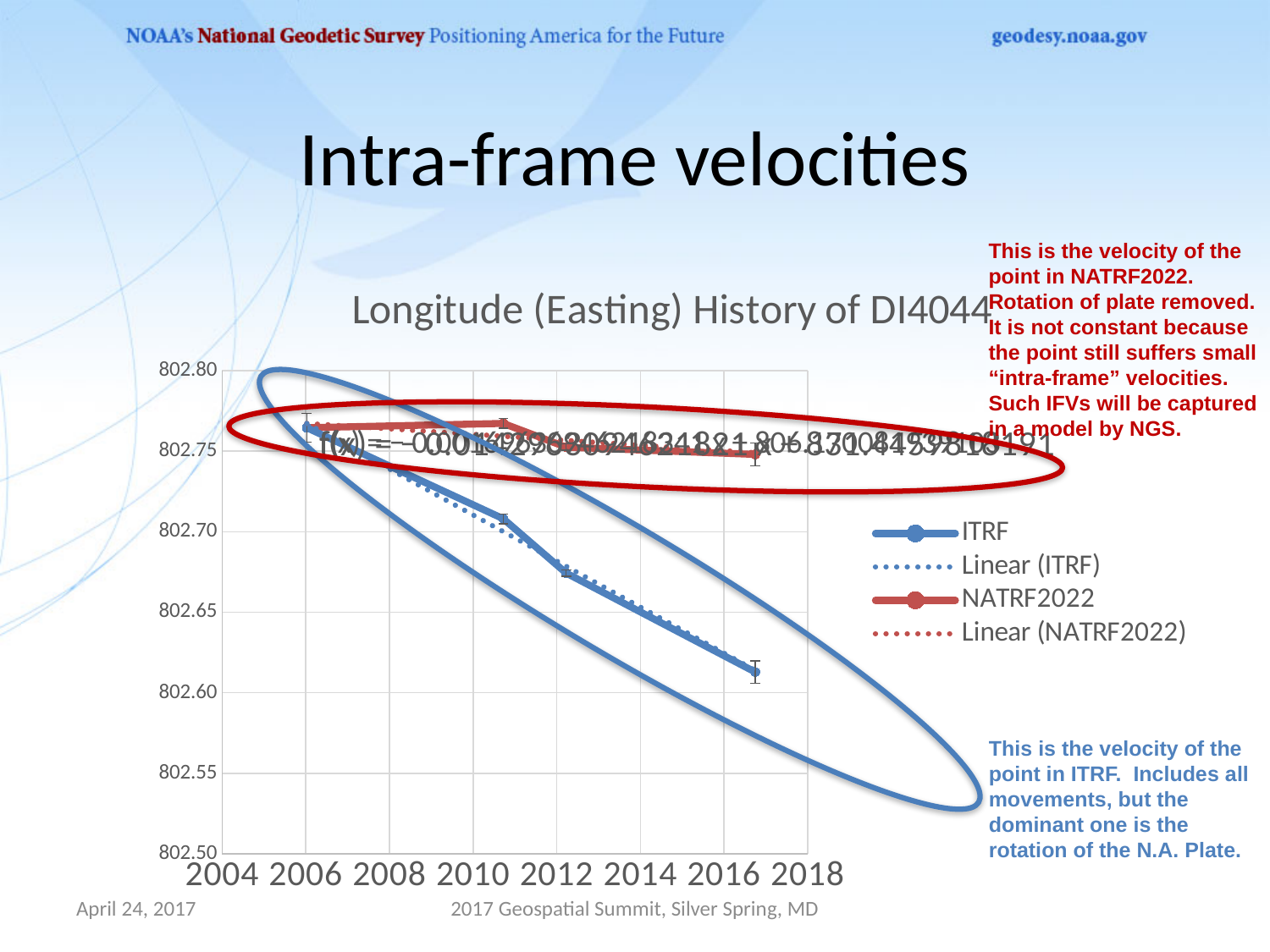
What kind of chart is shown on the slide? line chart At the rightmost data point (around 2017), which series has the larger value, ITRF or NATRF2022? NATRF2022 What is the title of the chart on the slide? Longitude (Easting) History of DI4044 Do the ITRF values rise or fall as the years increase along the x axis? fall Is the rightmost ITRF value (around 2017) greater or less than 802.65? less Which series shows the larger drop in value between its first and last data points, ITRF or NATRF2022? ITRF Which series is drawn in red on the chart? NATRF2022 Is the rightmost NATRF2022 value (around 2017) greater or less than 802.70? greater Is the ITRF value at the point around 2012 greater or less than 802.70? less How many entries does the chart legend list? 4 How many data points are plotted for the ITRF series? 4